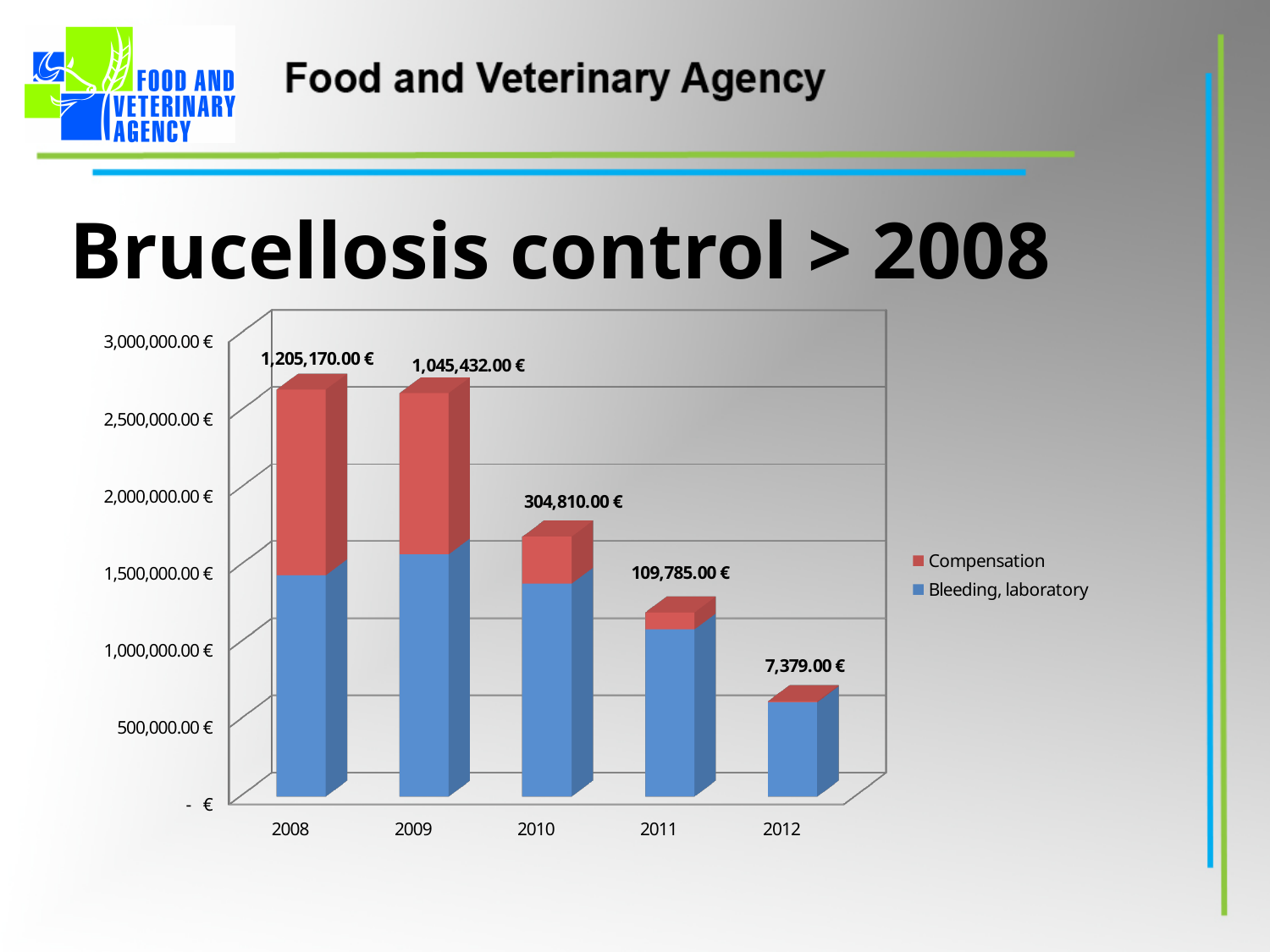
Is the Bleeding, laboratory value for 2012 greater or less than 1,000,000.00 €? less How many series does the legend list? 2 How many years are shown on the x axis? 5 What is the Compensation value for 2012? 7,379.00 € Which is larger, the Compensation value for 2010 or for 2011? 2010 What is the difference between the Compensation values for 2008 and 2009? 159,738.00 € Which year has the highest Compensation value? 2008 What is the Compensation value for 2010? 304,810.00 € What is the Compensation value for 2008? 1,205,170.00 € Which year has the lowest Compensation value? 2012 What kind of chart is shown on the slide? Stacked bar chart What is the Compensation value for 2011? 109,785.00 €